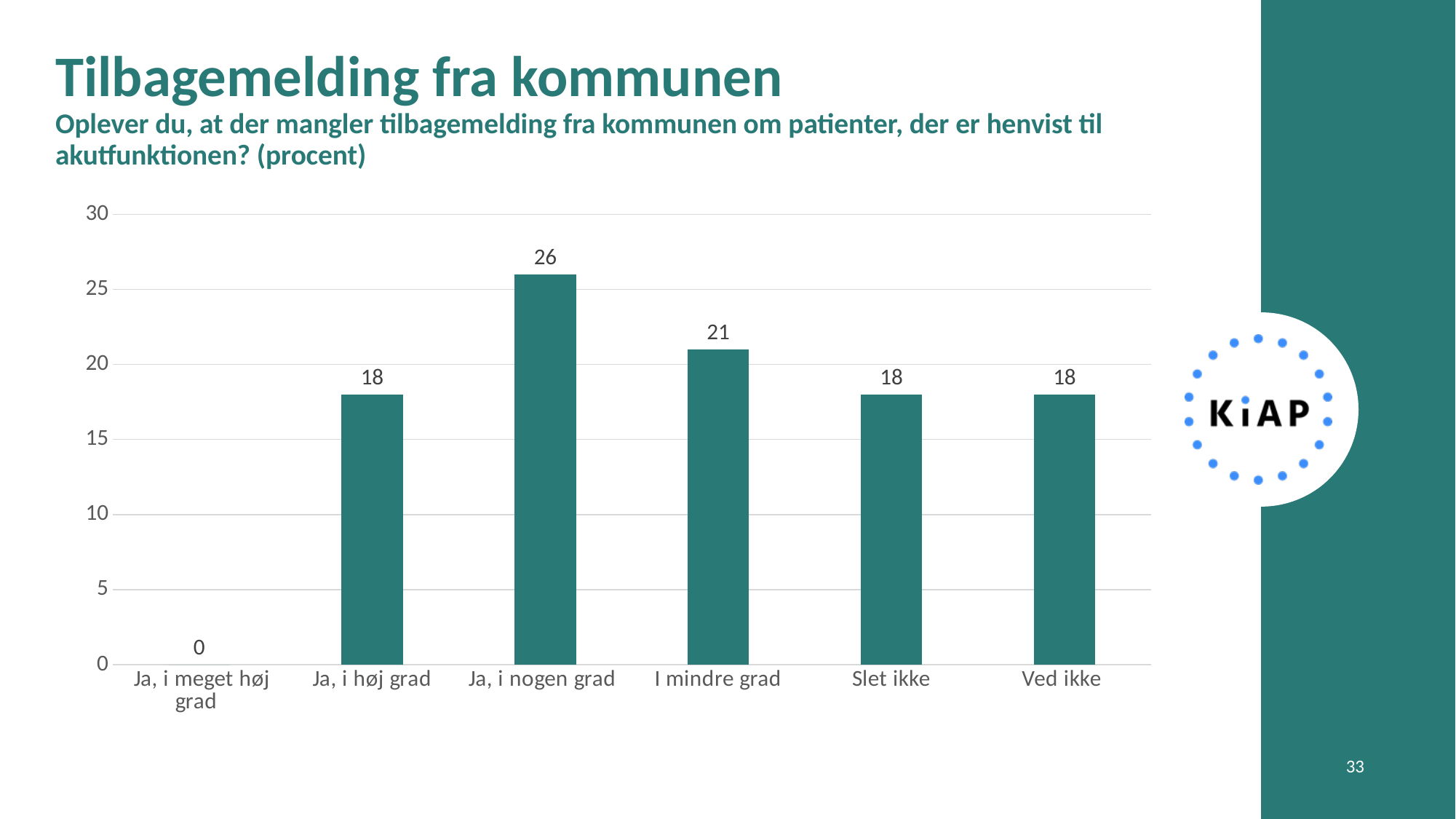
What is the difference between the values for "Ja, i nogen grad" and "I mindre grad"? 5 What is the value for "Ja, i meget høj grad"? 0 Is the value for "Ja, i nogen grad" greater or less than 25? greater What kind of chart is shown on the slide? bar chart What is the title of the slide? Tilbagemelding fra kommunen What is the value for "Ved ikke"? 18 What is the value for "I mindre grad"? 21 How many categories are shown on the x axis? 6 Which category has the highest value? Ja, i nogen grad Which is larger, the value for "Ja, i høj grad" or the value for "I mindre grad"? I mindre grad What is the value for "Ja, i nogen grad"? 26 Which category has the lowest value? Ja, i meget høj grad